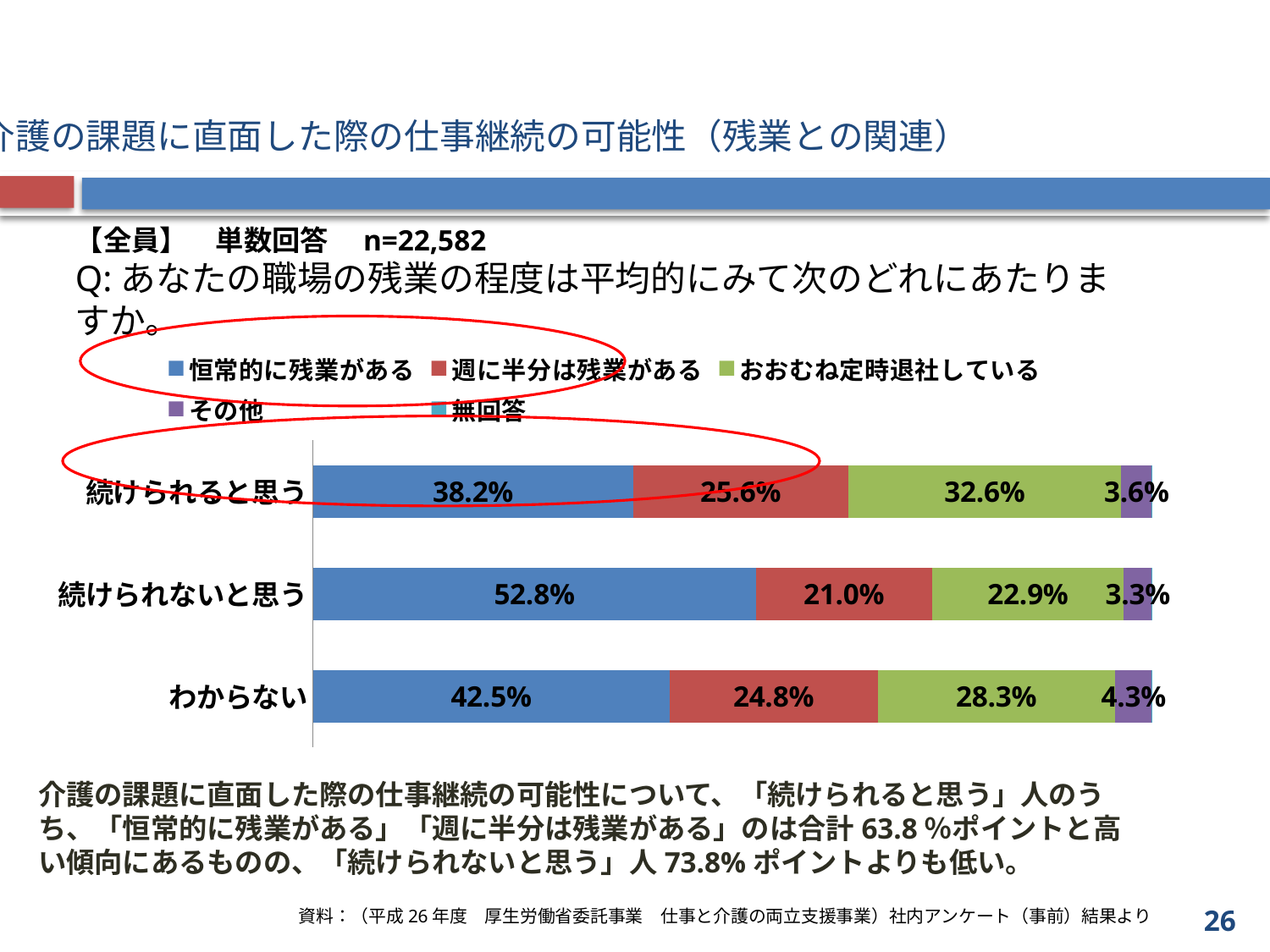
What is the value of 週に半分は残業がある for 続けられないと思う? 21.0% Which is larger: the 週に半分は残業がある value for 続けられると思う or for わからない? 続けられると思う What is the value of その他 for 続けられないと思う? 3.3% Which category has the highest value for 恒常的に残業がある? 続けられないと思う What is the value of 恒常的に残業がある for 続けられると思う? 38.2% How many categories (response groups) are plotted on the chart? 3 How many series does the legend list? 5 What is the value of おおむね定時退社している for わからない? 28.3% What kind of chart is shown on the slide? Stacked bar chart Which legend entry is shown in green? おおむね定時退社している Which category has the lowest value for おおむね定時退社している? 続けられないと思う What is the difference between the 恒常的に残業がある values for 続けられないと思う and 続けられると思う? 14.6%